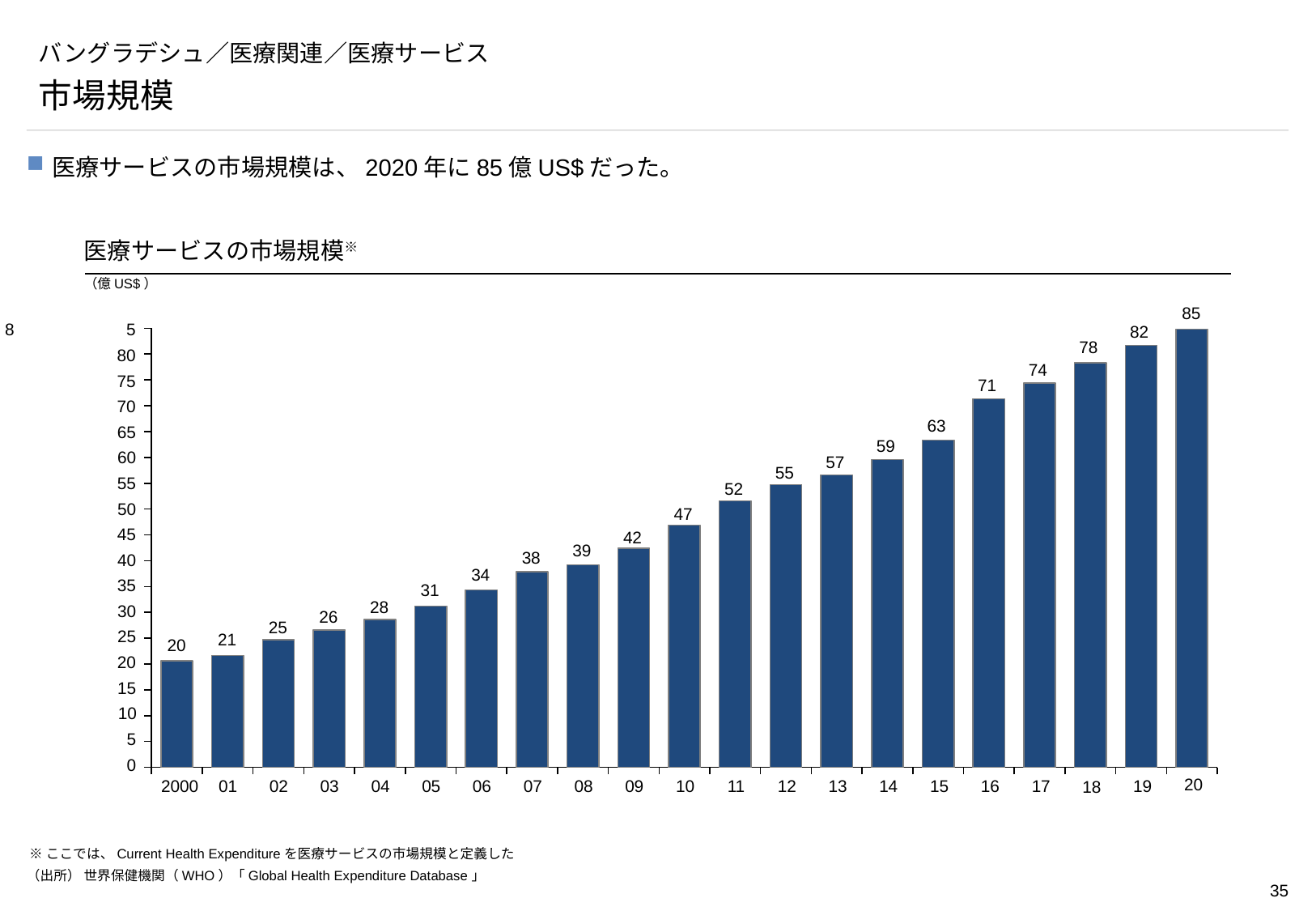
Do the values rise or fall from 2000 to 2020? rise What value is shown for the year 2000? 20 What unit is indicated for the values in the chart? 億US$ What was the market size of medical services in 2020 according to the chart? 85 Which year has the lowest value in the chart? 2000 Which is larger, the value for 2015 or the value for 2012? 2015 What is the difference between the values for 2020 and 2000? 65 What is the difference between the values for 2019 and 2018? 4 Which year has the highest value in the chart? 20 What value is shown for 2010? 47 How many years (bars) are plotted in the chart? 21 What type of chart is shown on the slide? bar chart